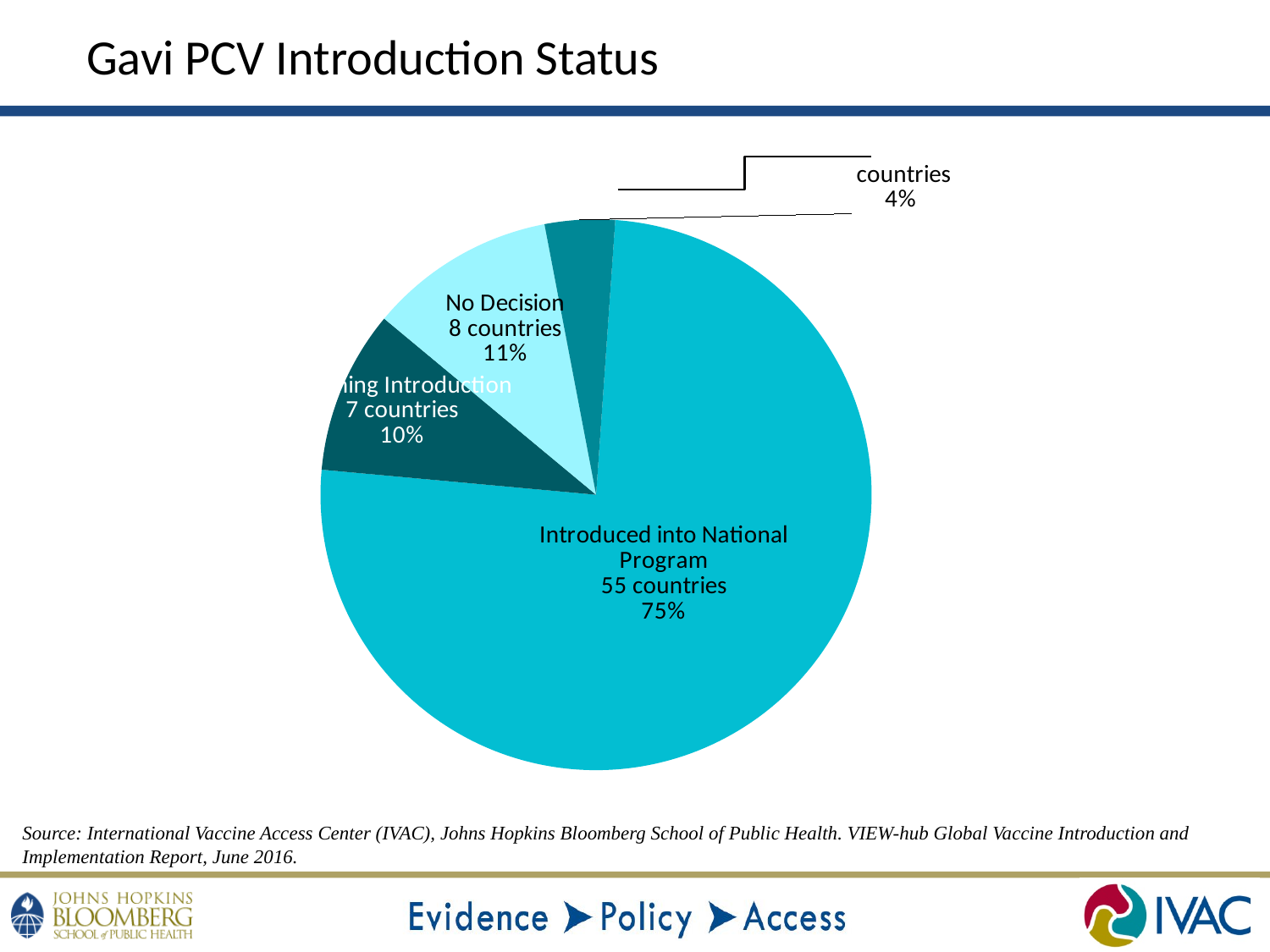
By how many percentage points does the 'Introduced into National Program' share exceed the 'No Decision' share? 64 percentage points Which slice is larger, 'No Decision' or 'Introduced into National Program'? Introduced into National Program What is the title of the slide containing the pie chart? Gavi PCV Introduction Status How many countries are in the 'Introduced into National Program' slice? 55 countries What percentage is shown for the smallest slice of the pie? 4% What share of the pie does the 'No Decision' slice represent? 11% Which category has the largest slice of the pie? Introduced into National Program How many slices does the pie chart have? 4 What kind of chart is shown on the slide? pie chart How many more countries are in 'Introduced into National Program' than in 'No Decision'? 47 countries How many countries are in the 'No Decision' category? 8 countries What percentage of the pie is labelled 'Introduced into National Program'? 75%